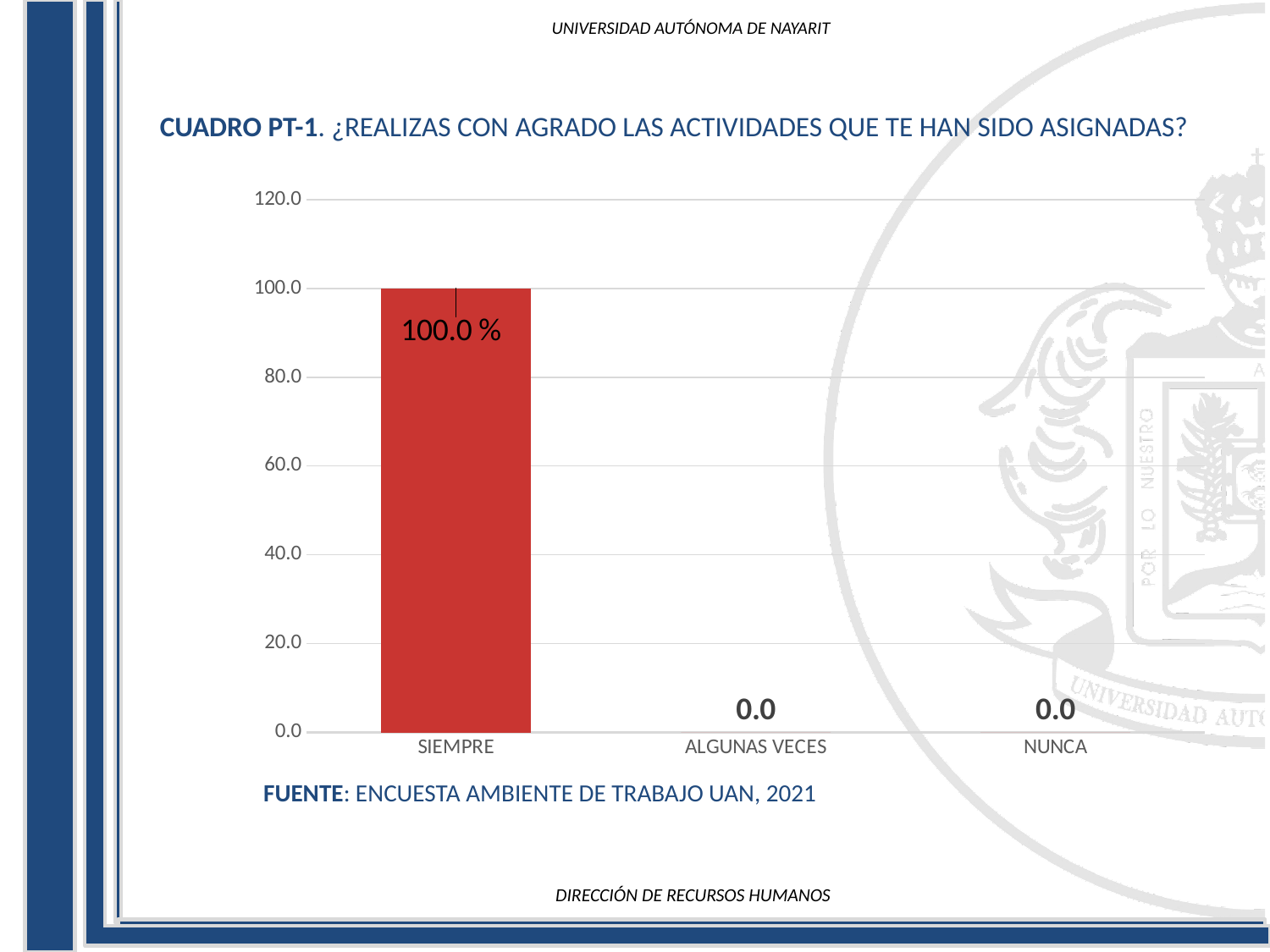
What is the value for SIEMPRE? 100.0 % Do the values rise or fall from SIEMPRE to NUNCA along the x axis? fall Is the value for SIEMPRE greater or less than 80.0? greater What is the highest tick value shown on the y axis? 120.0 What kind of chart is shown on the slide? bar chart Which is larger, the value for SIEMPRE or the value for ALGUNAS VECES? SIEMPRE What colour is the bar for SIEMPRE? red What is the value for NUNCA? 0.0 What is the value for ALGUNAS VECES? 0.0 Which category has the highest value? SIEMPRE What is the difference between the values for SIEMPRE and NUNCA? 100.0 How many categories are shown on the x axis? 3